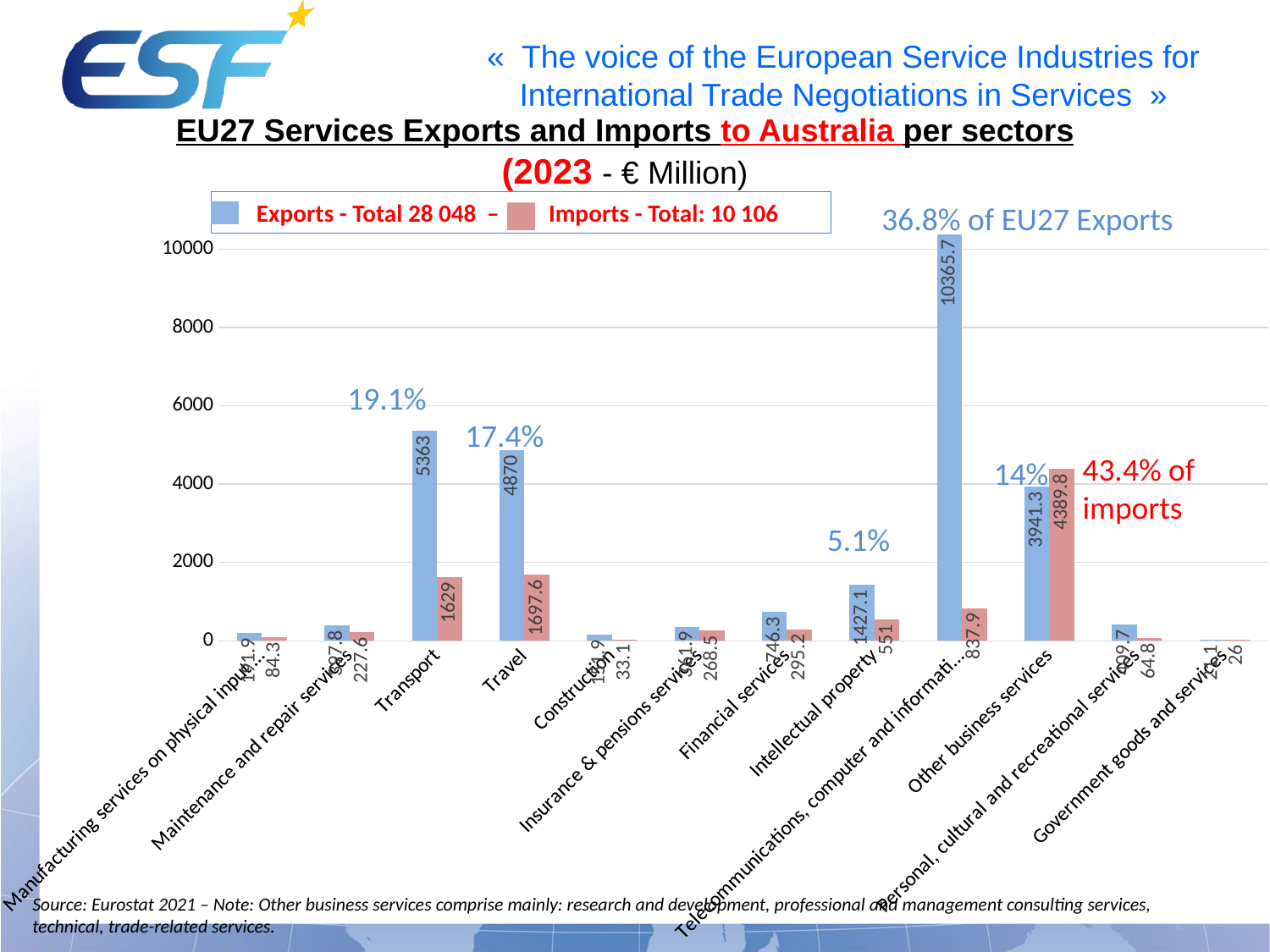
What is the value of EU27 exports to Australia for Transport? 5363 How many series does the legend list? 2 What kind of chart is shown on the slide? Bar chart What is the value of imports for Travel? 1697.6 Which sector has the highest exports value? Telecommunications, computer and information Which sector has the highest imports value? Other business services What is the value of exports for Intellectual property? 1427.1 For Other business services, which is larger: exports or imports? Imports According to the legend, what is the total of EU27 services exports to Australia? 28 048 What is the value of imports for Financial services? 295.2 How many sector categories are plotted on the x axis? 12 What is the difference between exports and imports for Transport? 3734